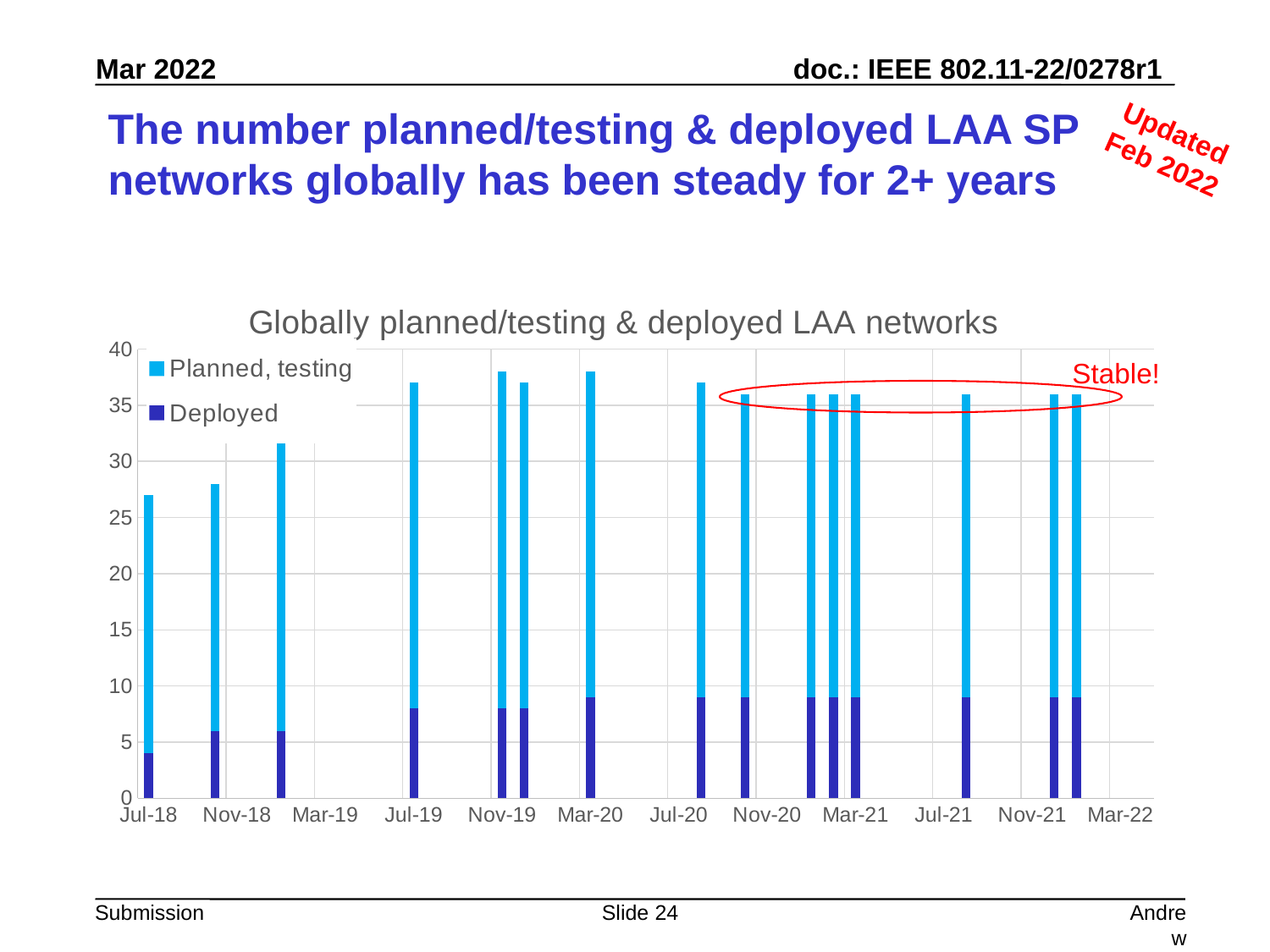
How do the total values change from Jul-18 to mid-2019, and then through early 2022? They rise, then stay roughly stable How many series does the legend of the chart list? 2 Which bar has the lowest total value? Jul-18 Is the total height of the first bar (Jul-18) greater or less than 30? less What kind of chart is shown on the slide? Stacked bar chart Is the total height of the first bar (Jul-18) greater or less than 25? greater What is the title of the chart? Globally planned/testing & deployed LAA networks Which series is drawn in dark blue at the bottom of each stacked bar? Deployed Is the Deployed value in the last bar (early 2022) greater or less than 5? greater